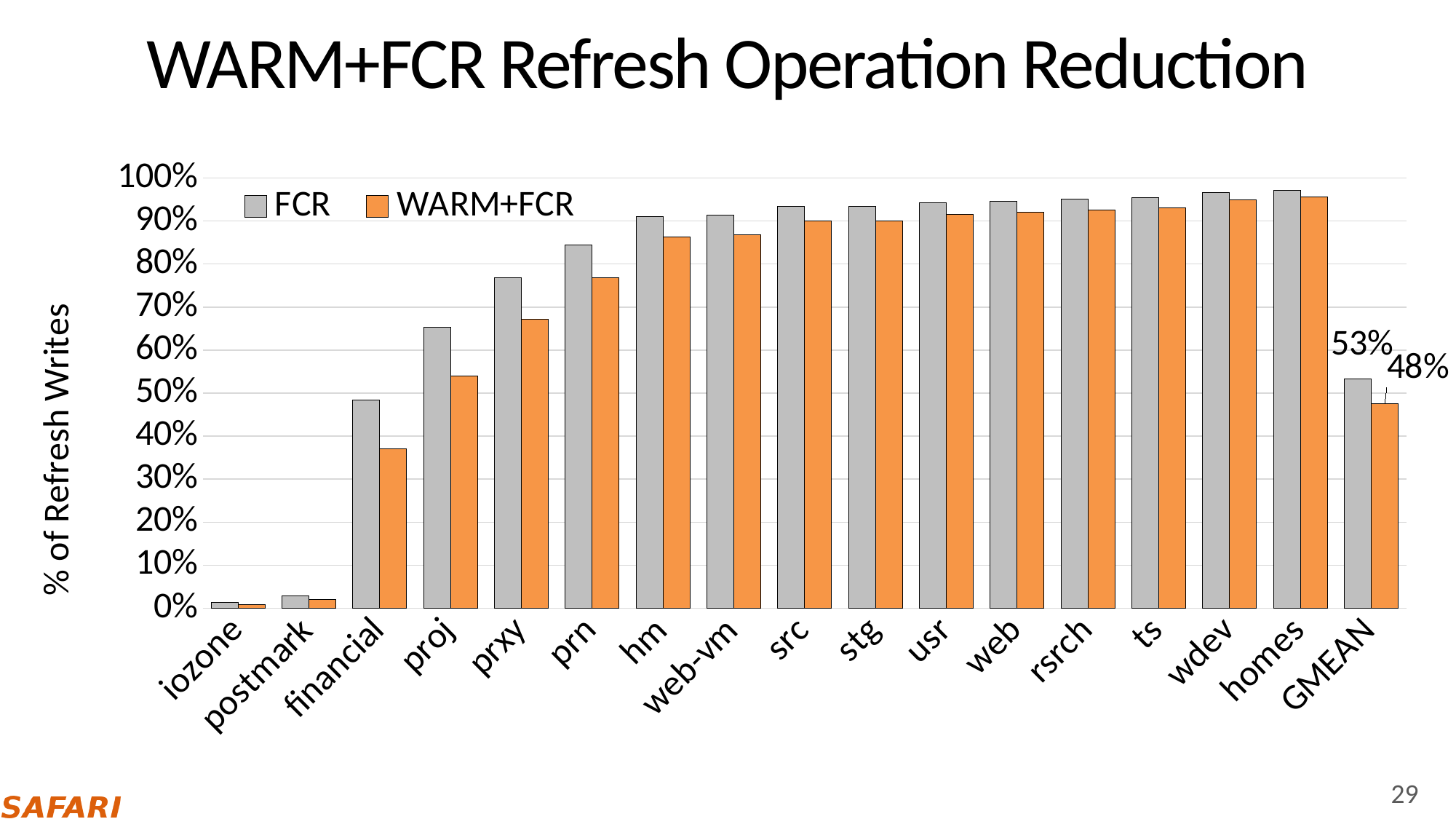
How many categories are shown on the x axis? 17 Is the WARM+FCR value for financial greater or less than 40%? less Which has the larger FCR value, proj or prxy? prxy What is the FCR value for GMEAN? 53% What is the label of the y axis? % of Refresh Writes What is the WARM+FCR value for GMEAN? 48% What is the difference between the FCR and WARM+FCR values for GMEAN? 5% How many series does the legend list? 2 Is the FCR value for prn greater or less than 80%? greater What kind of chart is shown on the slide? bar chart Which category has the lowest FCR value? iozone For financial, which series has the larger value, FCR or WARM+FCR? FCR